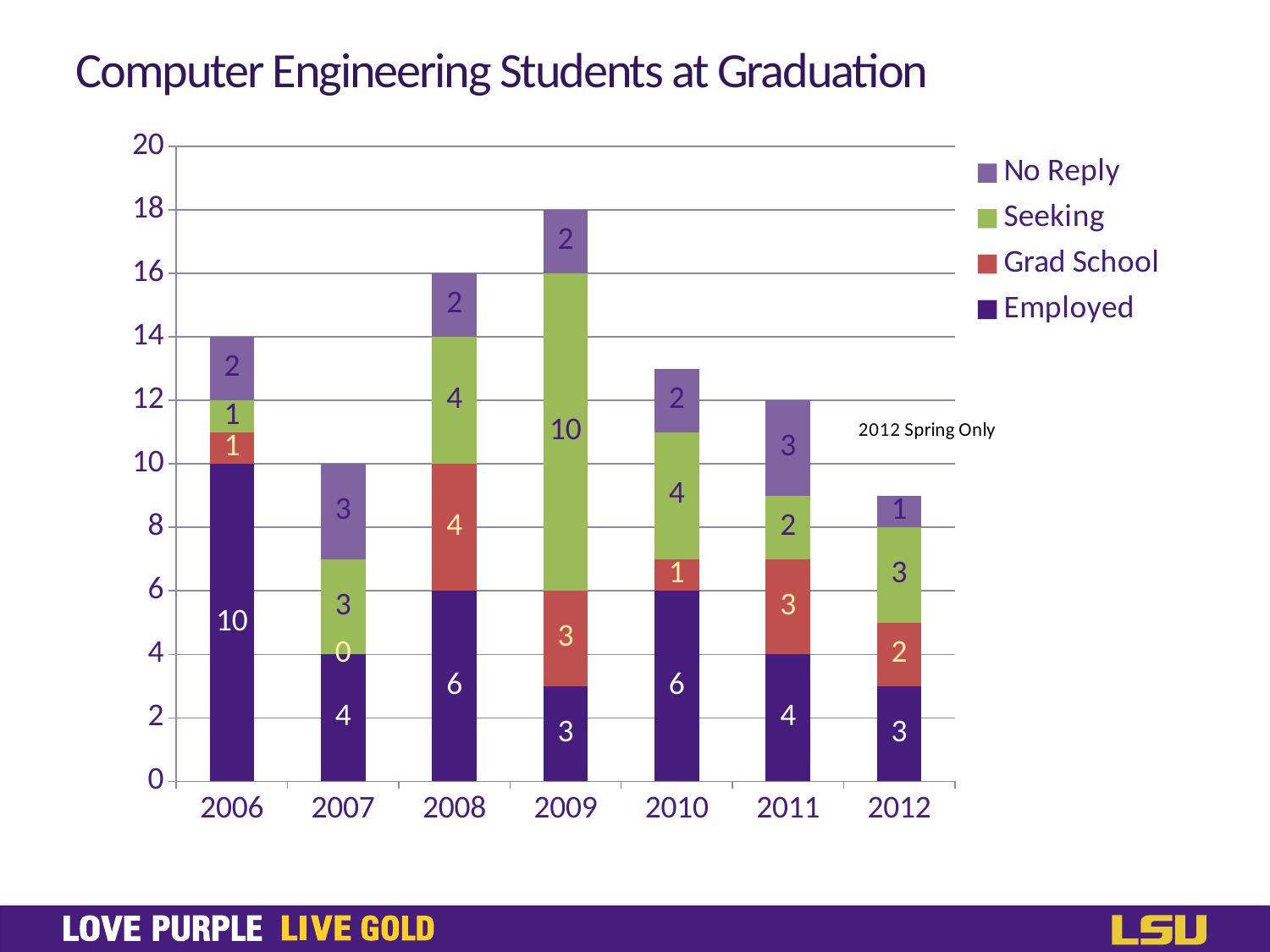
What kind of chart is shown on the slide? Stacked bar chart Which is larger, the Grad School value for 2008 or the Grad School value for 2010? 2008 What is the total height of the stacked bar for 2012? 9 What is the Seeking value for 2009? 10 What is the total height of the stacked bar for 2009? 18 What is the Grad School value for 2007? 0 Which year has the tallest stacked bar overall? 2009 What is the difference between the Employed values for 2006 and 2012? 7 What is the No Reply value for 2011? 3 What is the Employed value for 2006? 10 How many years are shown on the x axis? 7 How many series does the legend list? 4